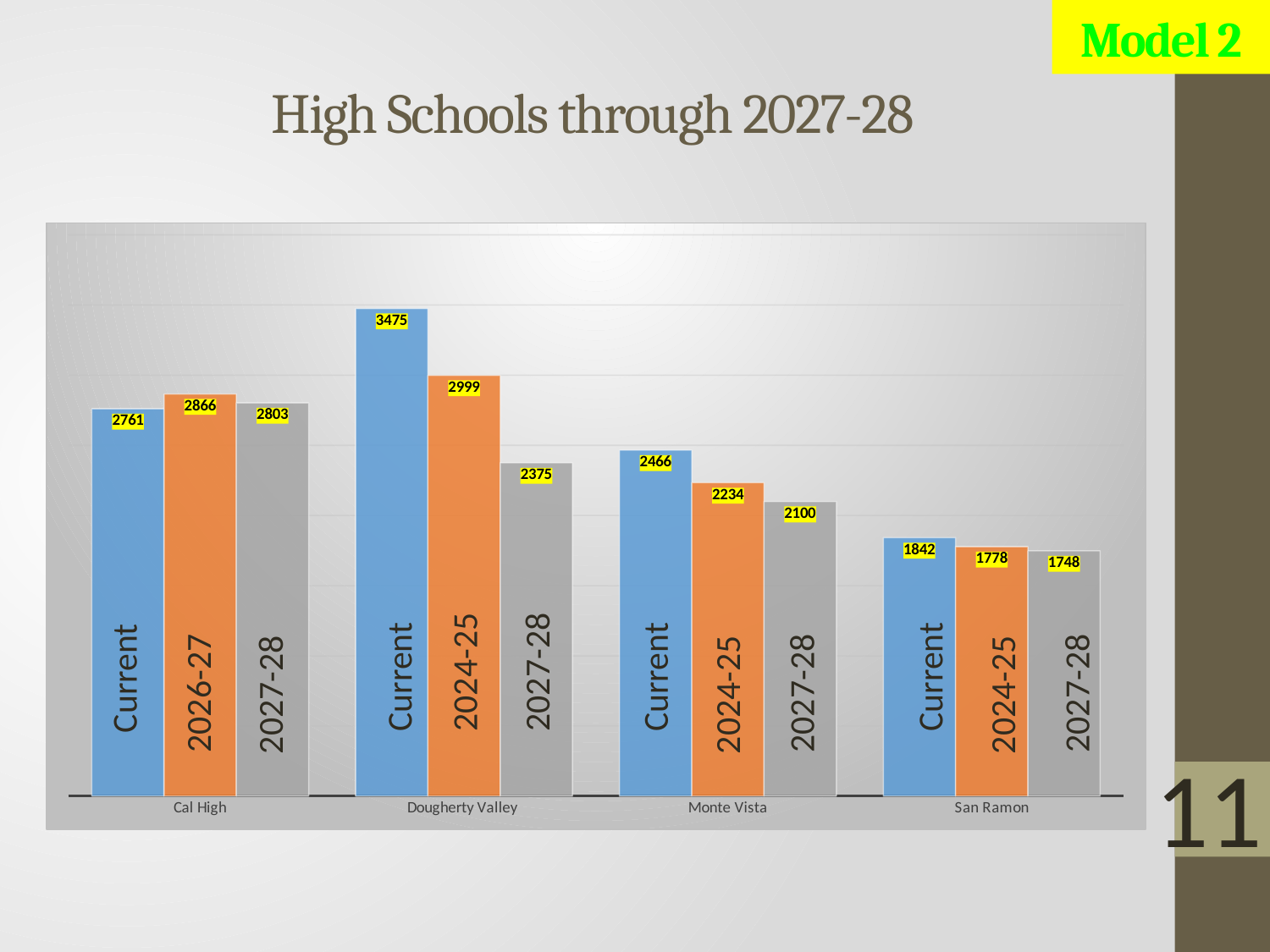
What is the 2024-25 value shown for San Ramon? 1778 What is the Current enrollment value shown for Dougherty Valley? 3475 How many schools are shown on the x axis of the chart? 4 What is the 2026-27 value shown for Cal High? 2866 Which is larger for Cal High: the Current value or the 2027-28 value? 2027-28 What is the difference between the Current and 2027-28 values for Dougherty Valley? 1100 What kind of chart is shown on the slide? Bar chart Do the values for Monte Vista rise or fall from Current to 2027-28? Fall Which school has the highest Current value? Dougherty Valley What is the title of the chart on the slide? High Schools through 2027-28 What is the 2027-28 value shown for Monte Vista? 2100 Which school has the lowest 2027-28 value? San Ramon